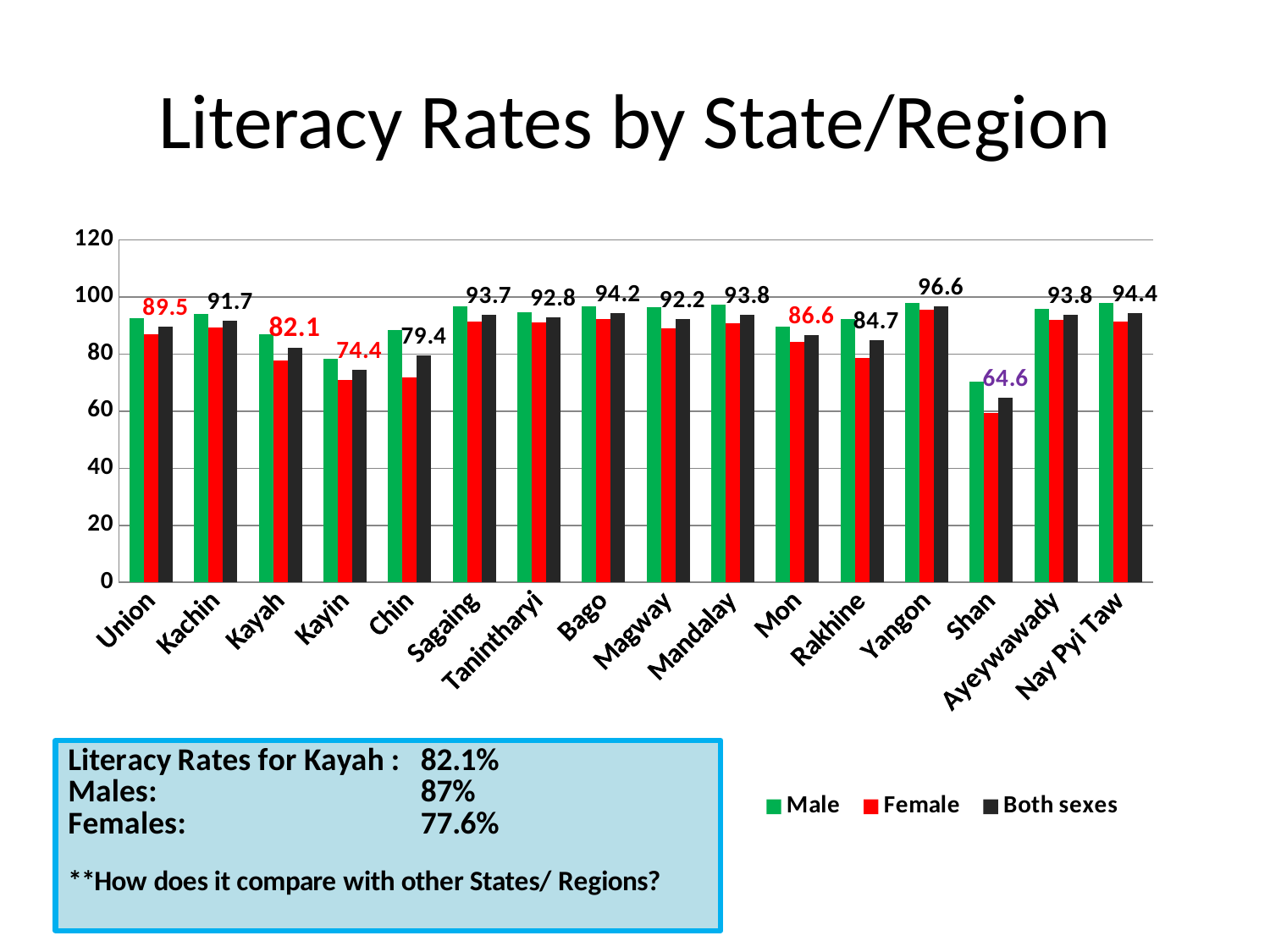
Which state/region has the lowest Both sexes literacy rate? Shan What is the Both sexes literacy rate for Yangon? 96.6 What is the Both sexes literacy rate for Shan? 64.6 How many states/regions (including Union) are shown on the x axis? 16 Which has a higher Both sexes literacy rate, Kayin or Chin? Chin What is the difference between the Both sexes literacy rates of Yangon and Shan? 32 Which state/region has the highest Both sexes literacy rate? Yangon How many series does the legend list? 3 What kind of chart is shown on the slide? Bar chart What is the Both sexes literacy rate for Kayah? 82.1